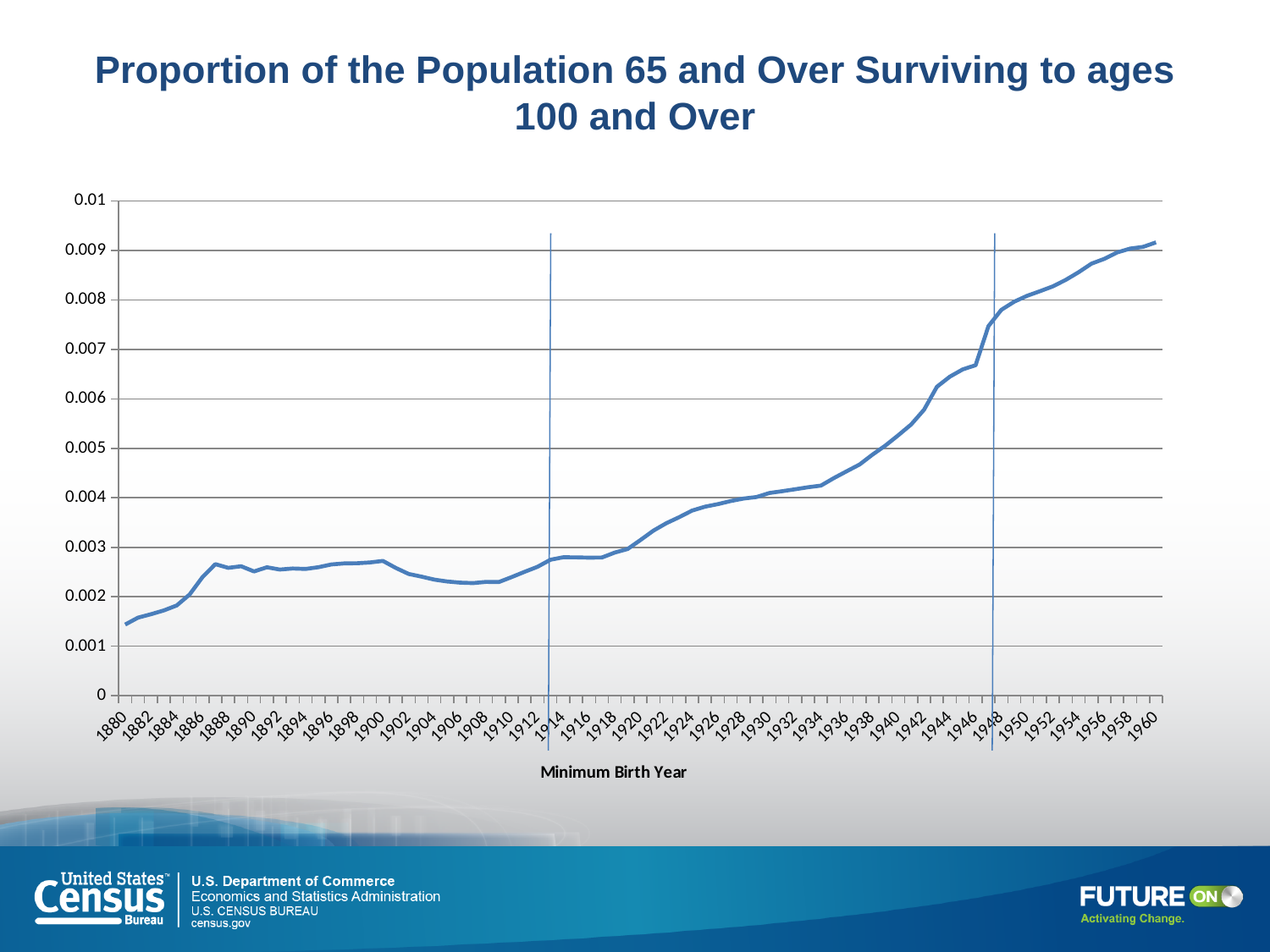
What is the label of the x axis? Minimum Birth Year Is the value for 1960 greater or less than 0.008? greater Which minimum birth year has the lowest proportion? 1880 Is the value for 1880 greater or less than 0.001? greater Which has a larger value, 1900 or 1940? 1940 What kind of chart is shown on the slide? line chart What is the title of the chart? Proportion of the Population 65 and Over Surviving to ages 100 and Over Is the value for 1900 greater or less than 0.003? less Which minimum birth year has the highest proportion? 1960 Overall, does the proportion rise or fall from 1880 to 1960? rise